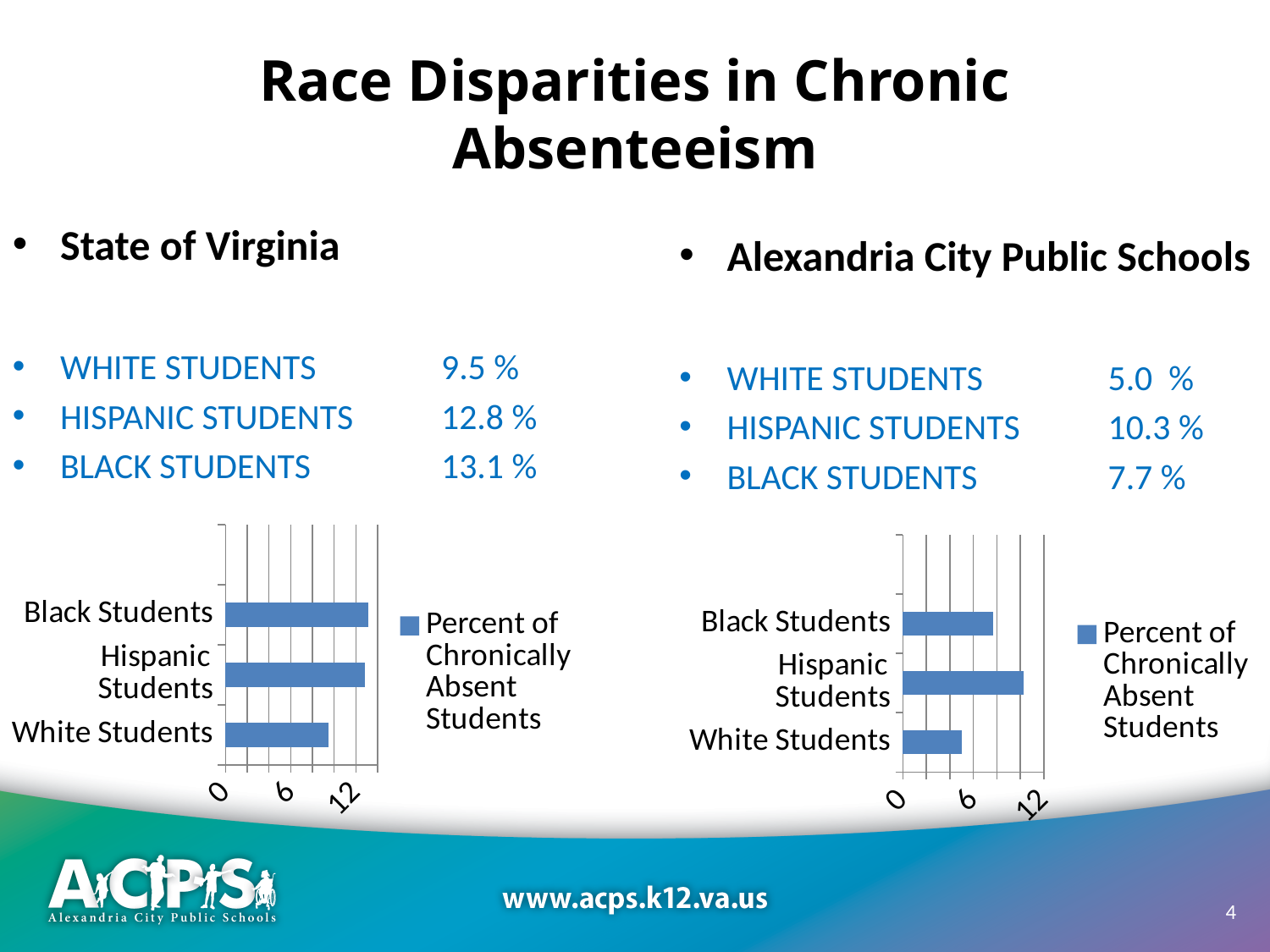
In the Alexandria City Public Schools chart on the right, how many series does the legend list? 1 In the Alexandria City Public Schools chart on the right, what is the legend entry for the plotted series? Percent of Chronically Absent Students In the State of Virginia chart on the left, which is larger: the value for Hispanic Students or the value for White Students? Hispanic Students In the Alexandria City Public Schools chart on the right, is the value for Hispanic Students greater or less than 6? greater In the State of Virginia chart on the left, which student group has the lowest percent of chronically absent students? White Students What type of chart is shown on the left side of the slide (State of Virginia)? bar chart In the State of Virginia chart on the left, how many student categories are plotted? 3 In the Alexandria City Public Schools chart on the right, which is larger: the value for Black Students or the value for White Students? Black Students In the Alexandria City Public Schools chart on the right, which student group has the highest percent of chronically absent students? Hispanic Students In the Alexandria City Public Schools chart on the right, is the value for White Students greater or less than 6? less In the State of Virginia chart on the left, is the value for White Students greater or less than 6? greater In the Alexandria City Public Schools chart on the right, which student group has the lowest percent of chronically absent students? White Students